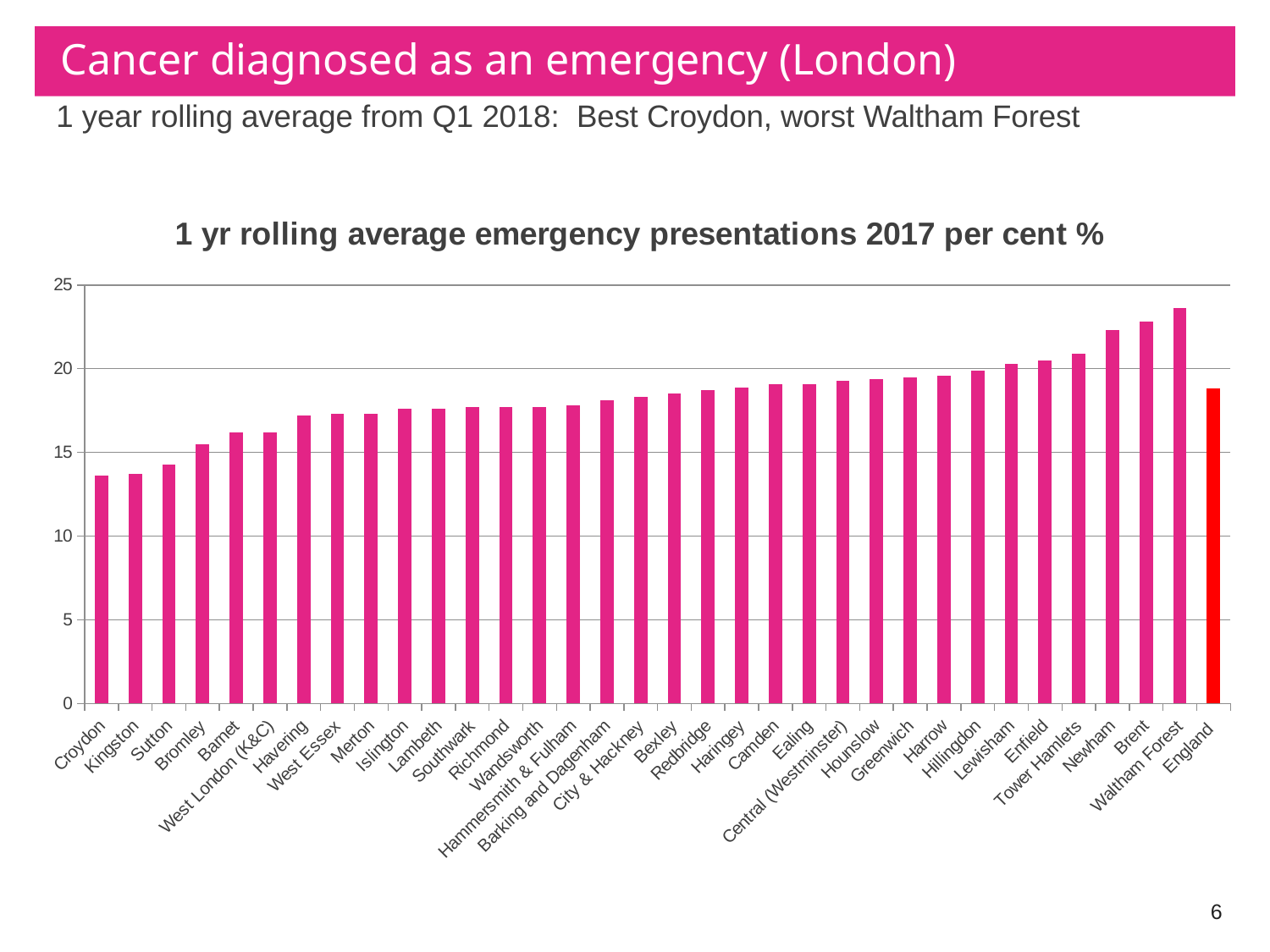
Is the value for Havering greater or less than 15? greater Which category has the highest value in the chart? Waltham Forest Which category has the lowest value in the chart? Croydon Is the value for England greater or less than 20? less Is the value for Croydon greater or less than 15? less Which has the larger value, Sutton or Newham? Newham What kind of chart is shown on the slide? bar chart Do the values for the London boroughs rise or fall from left to right along the x axis? rise What is the title of the chart? 1 yr rolling average emergency presentations 2017 per cent % Which has the larger value, Brent or Croydon? Brent